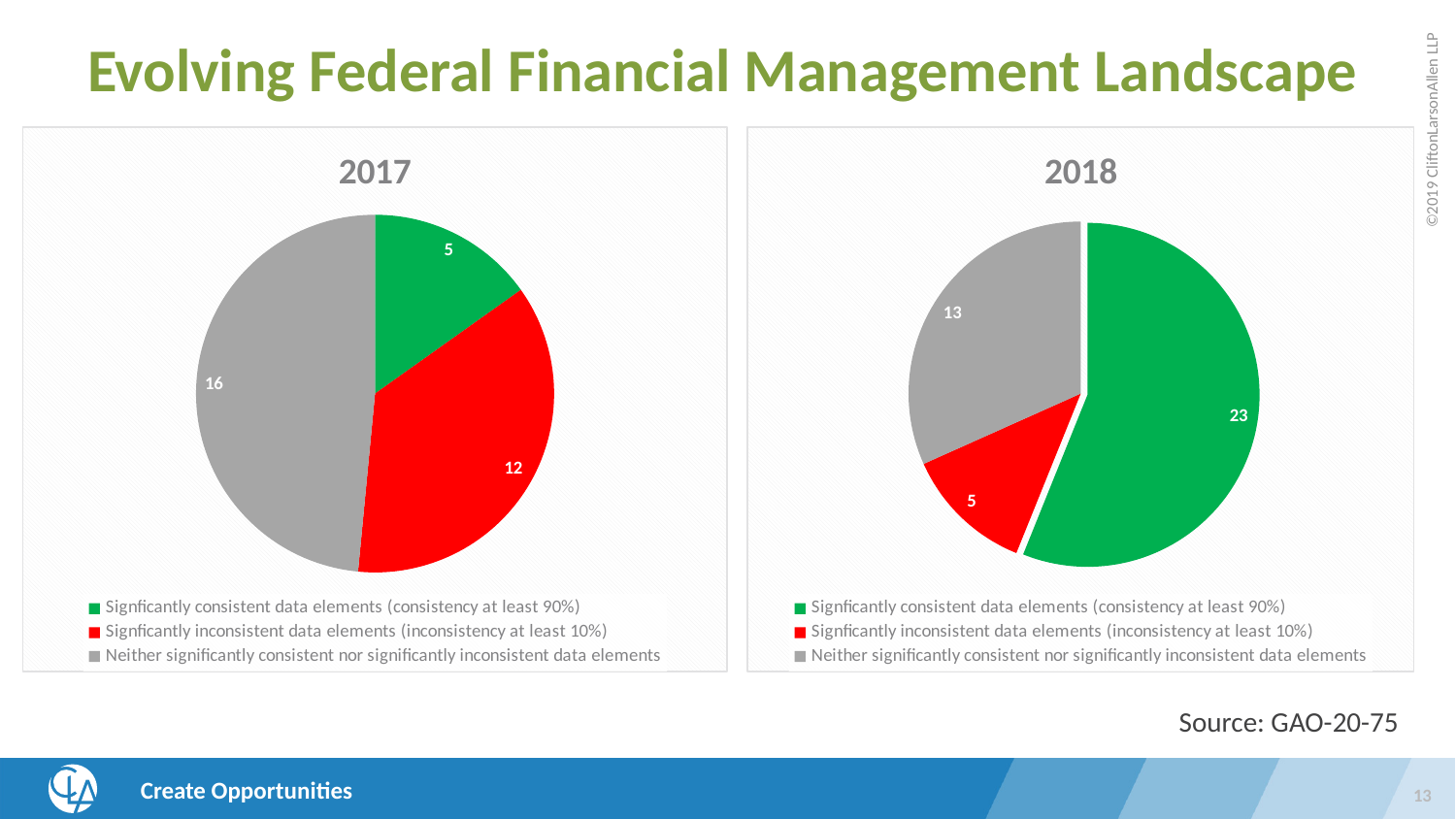
In the 2018 chart, what is the value for significantly consistent data elements? 23 In the 2017 chart, what is the value for significantly inconsistent data elements? 12 What type of chart is used for the 2017 data? Pie chart What is the difference between the significantly consistent values in the 2018 chart and the 2017 chart? 18 How many slices does the 2018 pie chart have? 3 In the 2017 chart, what is the value for significantly consistent data elements? 5 In the 2018 chart, what is the value for neither significantly consistent nor significantly inconsistent data elements? 13 In the 2017 chart, which is larger: significantly inconsistent data elements or significantly consistent data elements? Significantly inconsistent data elements In the 2018 chart, which category has the smallest slice? Significantly inconsistent data elements What is the total of all slices in the 2017 pie chart? 33 In the 2017 chart, which category has the largest slice? Neither significantly consistent nor significantly inconsistent data elements What colour represents significantly inconsistent data elements in the legends? Red